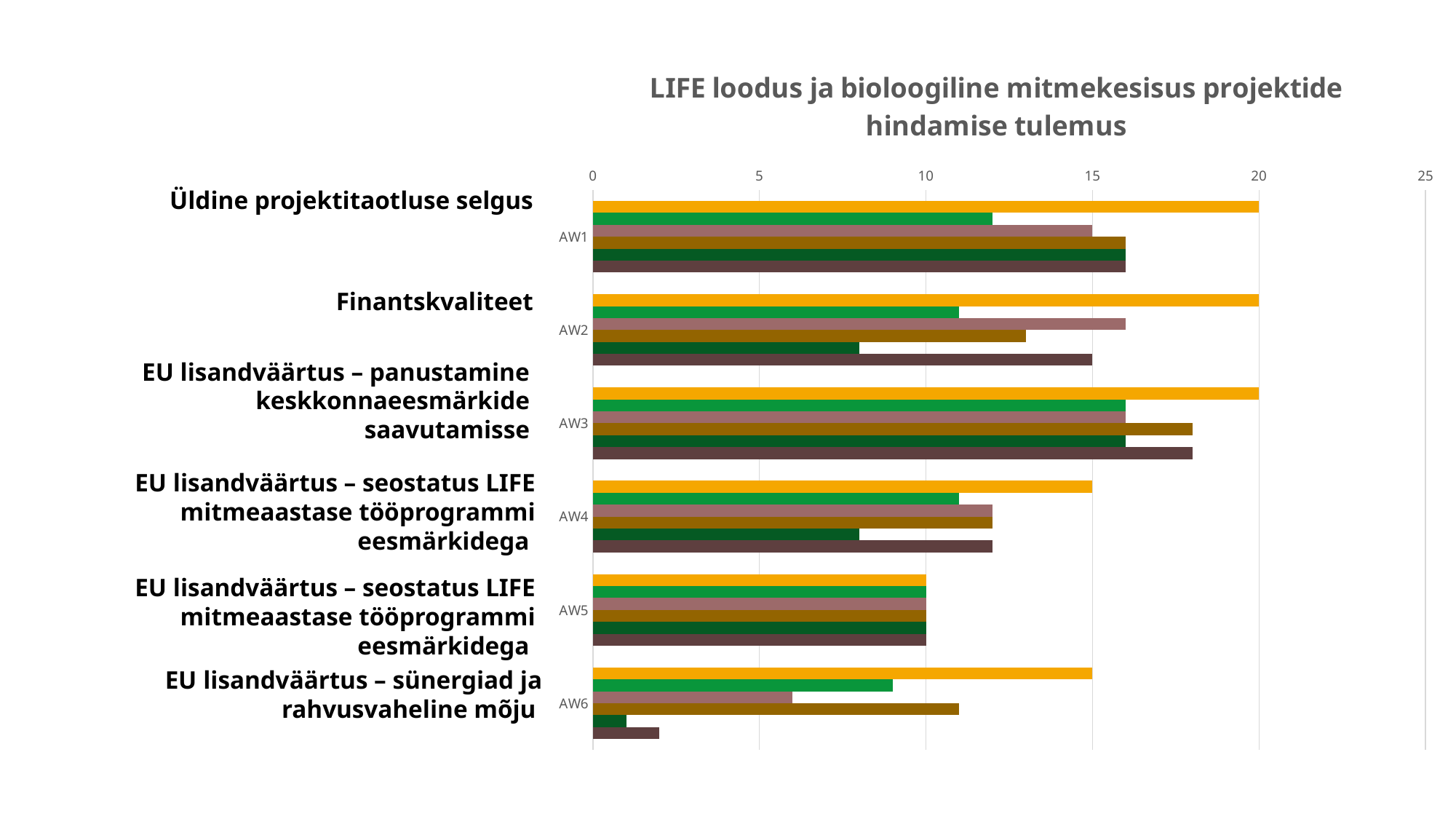
What is the value of the first (orange) bar for AW4? 15 Is the value of the brown bar for AW3 greater or less than 15? greater What kind of chart is shown on the slide? bar chart How many categories (AW groups) are plotted on the chart? 6 Which is larger: the orange bar for AW1 or the orange bar for AW6? AW1 Which AW category has the shortest last (dark brown) bar? AW6 Is the value of the dark green bar for AW2 greater or less than 10? less What is the title of the chart? LIFE loodus ja bioloogiline mitmekesisus projektide hindamise tulemus What value do all the bars for AW5 reach? 10 How many bars are plotted for each AW category? 6 What is the value of the first (orange) bar for AW1? 20 Is the value of the last (dark brown) bar for AW6 greater or less than 5? less